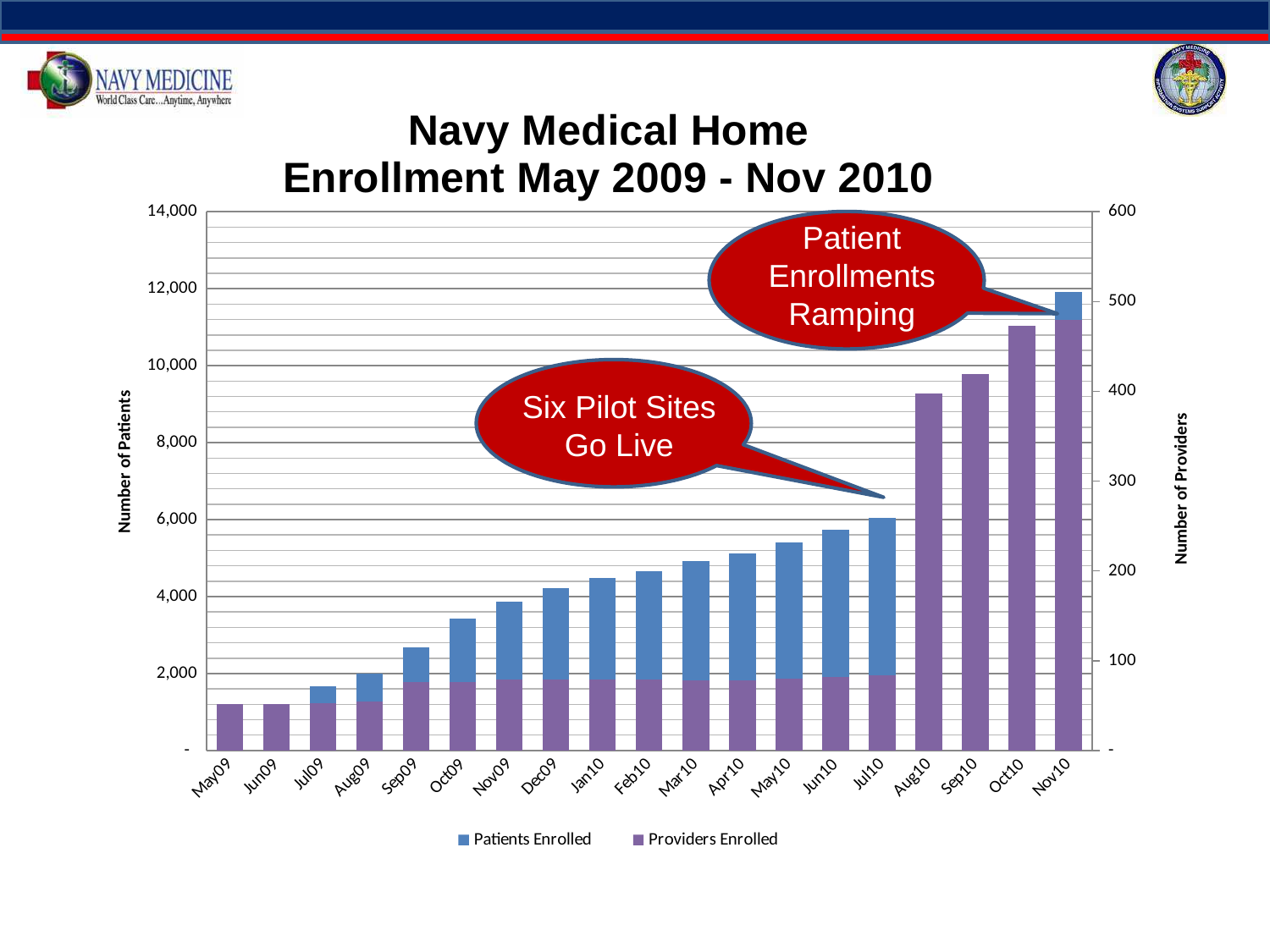
Is the Patients Enrolled value for Mar10 greater or less than 4,000? greater What is the title of the chart? Navy Medical Home Enrollment May 2009 - Nov 2010 How many series does the legend list? 2 How many months are shown along the x axis? 19 What is the label of the right-hand vertical axis? Number of Providers Is the Patients Enrolled value for Nov10 greater or less than 10,000? greater Which month has the highest number of Patients Enrolled? Nov10 Which month has more Patients Enrolled, Oct10 or Jul10? Oct10 What kind of chart is shown on the slide? Bar chart Do the Patients Enrolled values generally rise or fall from May09 to Nov10? Rise Is the Patients Enrolled value for Sep09 greater or less than 4,000? less